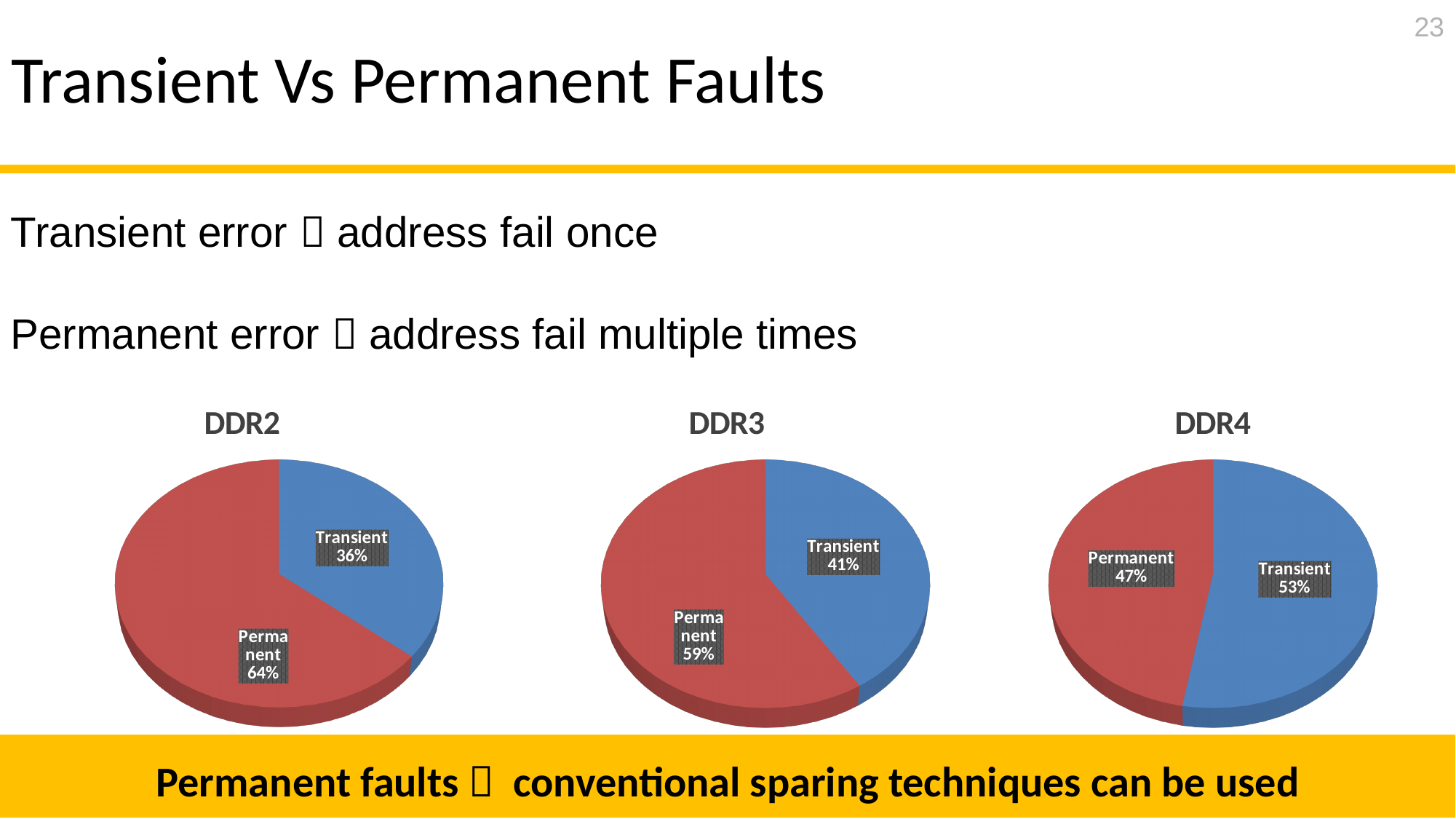
In the DDR4 chart, what share of faults is Transient? 53% In the DDR3 chart, what share of faults is Transient? 41% In the DDR3 chart, what share of faults is Permanent? 59% In the DDR2 chart, which slice is larger, Transient or Permanent? Permanent What kind of chart is the DDR3 chart? Pie chart How many pie charts are shown on the slide? 3 In the DDR2 chart, what share of faults is Permanent? 64% In the DDR3 chart, what is the difference in percentage points between the Permanent and Transient slices? 18 In the DDR2 chart, what share of faults is Transient? 36% In the DDR4 chart, which slice is larger, Transient or Permanent? Transient How many slices does the DDR4 pie chart have? 2 In the DDR4 chart, what share of faults is Permanent? 47%